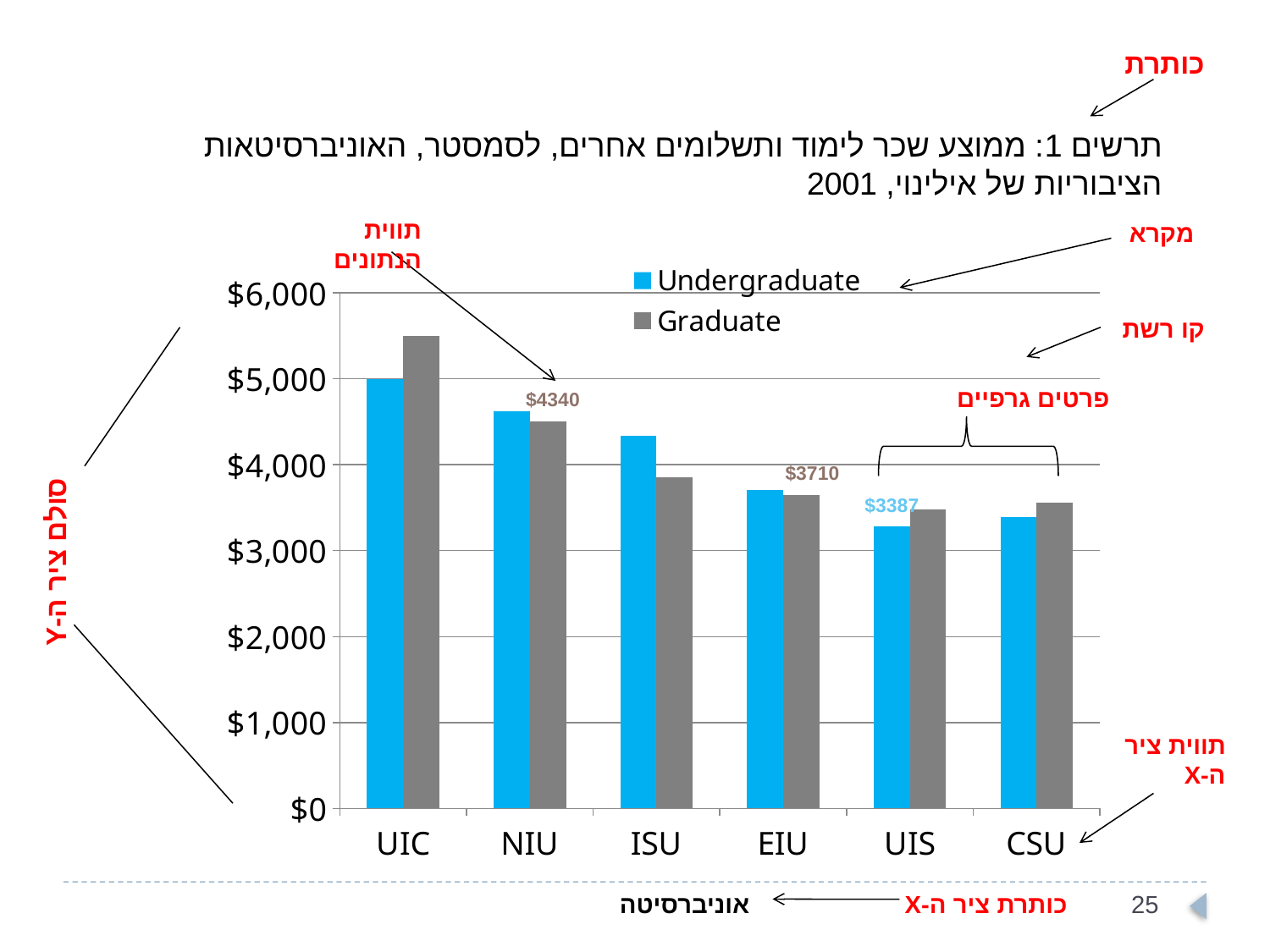
How many universities are shown on the x axis? 6 Which university has the highest Graduate value? UIC Which university has the highest Undergraduate value? UIC How many series does the legend list? 2 For UIC, which is larger: the Undergraduate or the Graduate value? Graduate What kind of chart is shown on the slide? bar chart Is the Graduate value for ISU greater or less than $4,000? less For ISU, which is larger: the Undergraduate or the Graduate value? Undergraduate Is the Graduate value for UIC greater or less than $5,000? greater